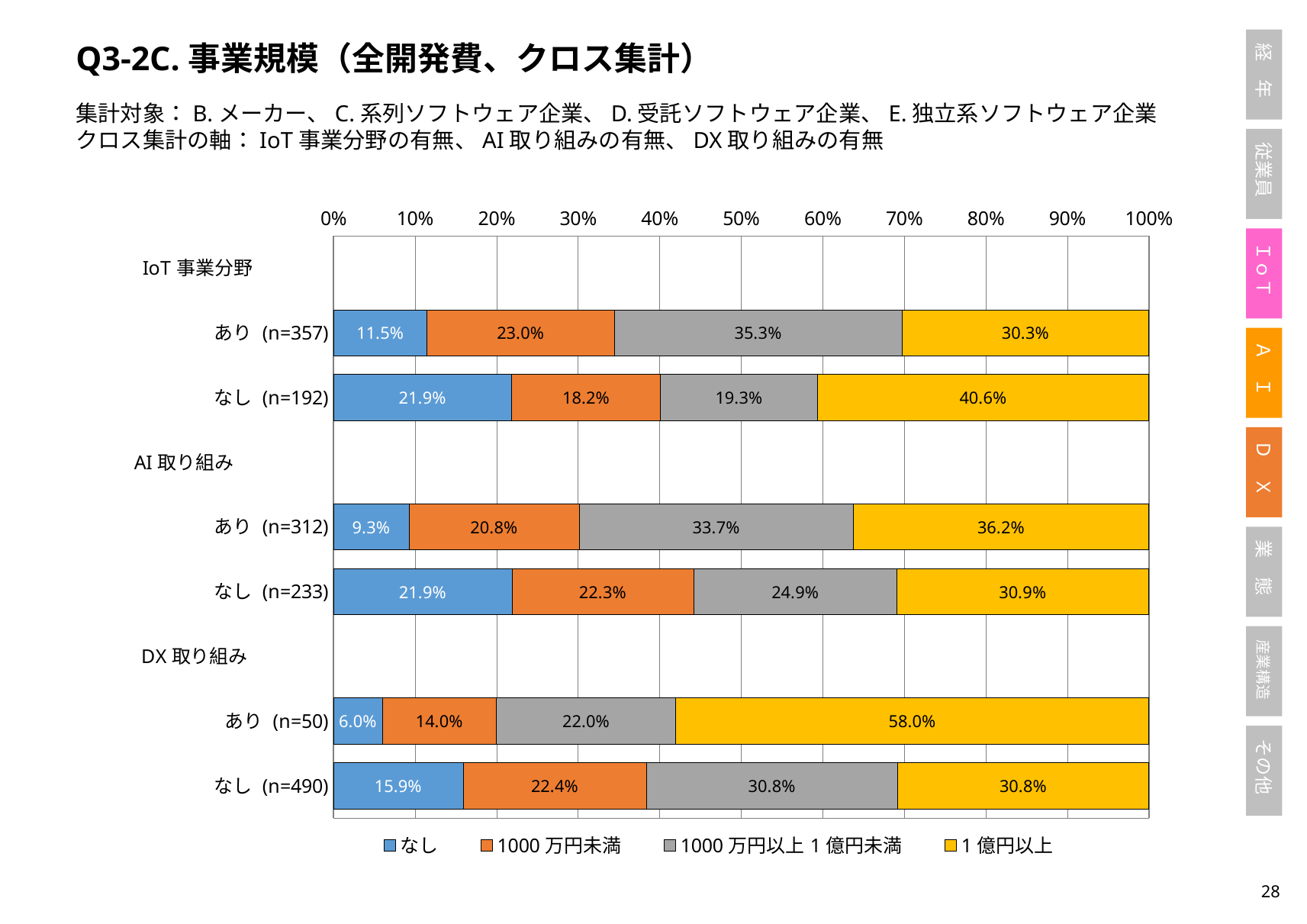
What is the difference between the 1億円以上 values for IoT事業分野 なし (n=192) and IoT事業分野 あり (n=357)? 10.3% Which is larger: the 1000万円以上1億円未満 value for AI取り組み あり (n=312) or for AI取り組み なし (n=233)? AI取り組み あり (n=312) What is the value of the 1000万円未満 segment for DX取り組み なし (n=490)? 22.4% What colour represents the 1億円以上 series? Yellow Which bar has the lowest value for the なし segment? DX取り組み あり (n=50) How many series does the legend list? 4 What is the value of the 1000万円以上1億円未満 segment for AI取り組み あり (n=312)? 33.7% What is the value of the なし segment for IoT事業分野 あり (n=357)? 11.5% How many bars are plotted in the chart? 6 What is the value of the 1億円以上 segment for DX取り組み あり (n=50)? 58.0% What kind of chart is shown on the slide? Stacked bar chart Which bar has the highest value for the 1億円以上 segment? DX取り組み あり (n=50)